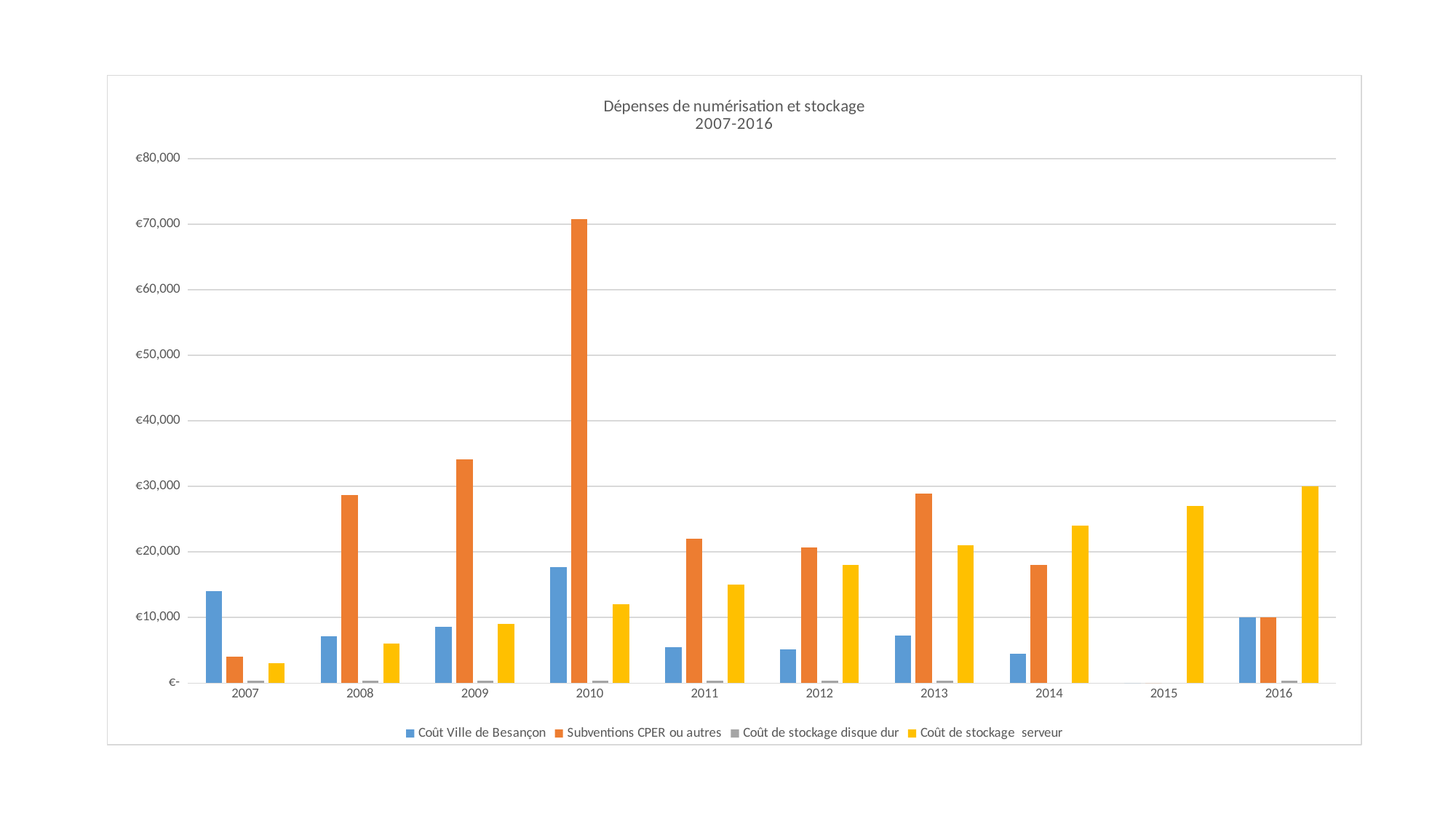
How many years are shown on the x axis? 10 Is the value for Subventions CPER ou autres in 2010 greater or less than €60,000? greater In 2009, which is larger: Subventions CPER ou autres or Coût Ville de Besançon? Subventions CPER ou autres In which year is the value for Coût de stockage serveur lowest? 2007 Is the value for Coût Ville de Besançon in 2007 greater or less than €10,000? greater In which year is the value for Subventions CPER ou autres highest? 2010 Is the value for Coût de stockage serveur in 2016 greater or less than €20,000? greater How many series does the legend list? 4 What kind of chart is shown on the slide? bar chart Does the value for Coût de stockage serveur rise or fall from 2007 to 2016? rise What is the title of the chart? Dépenses de numérisation et stockage 2007-2016 In which year is the value for Coût Ville de Besançon highest? 2010